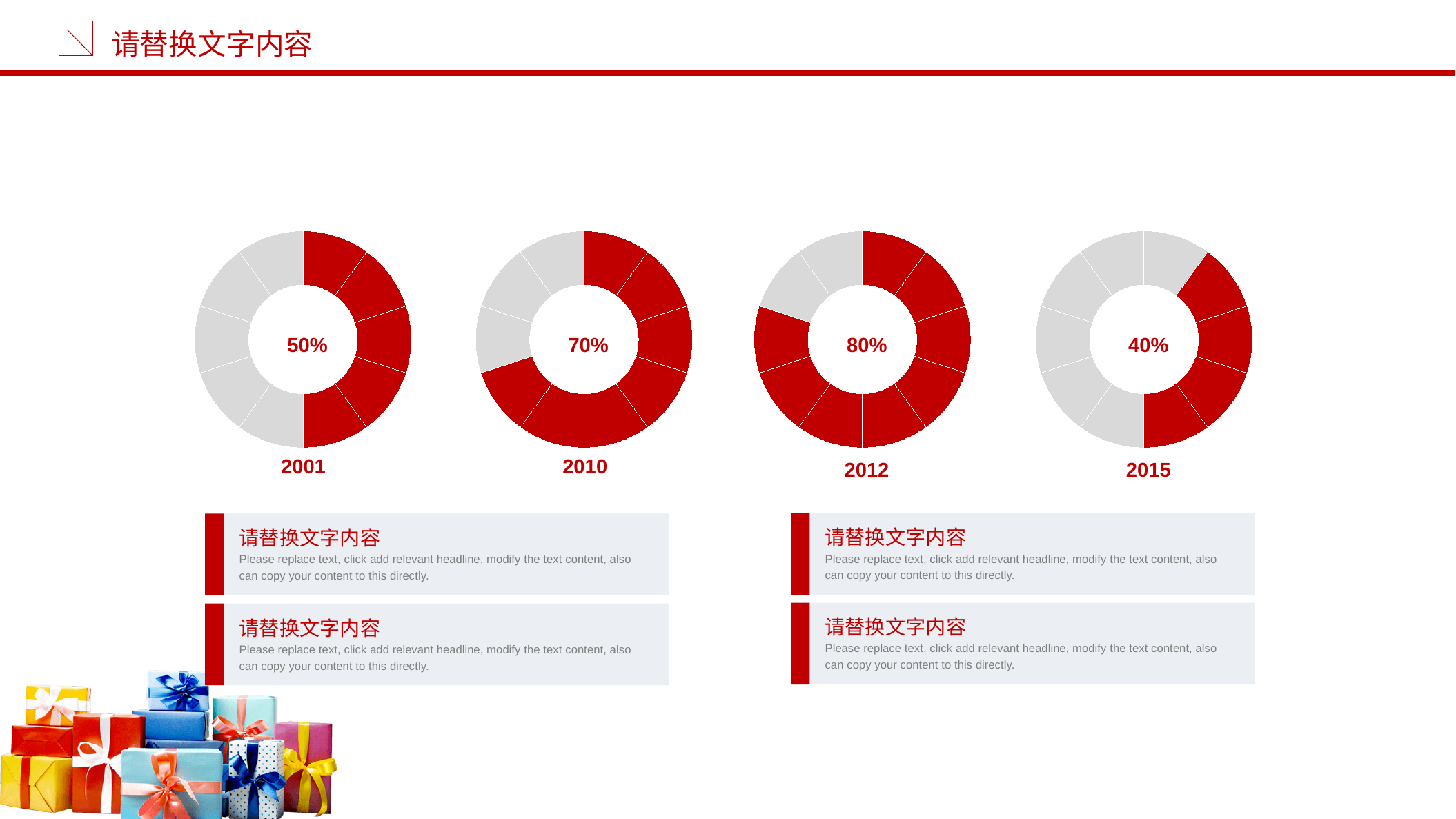
What colour is the filled (highlighted) portion of each donut chart? Red What percentage is shown in the centre of the donut chart labelled 2001? 50% What is the difference between the percentage in the 2010 donut chart and the percentage in the 2015 donut chart? 30% How many donut charts are shown on the slide? 4 What percentage is shown in the centre of the donut chart labelled 2012? 80% What kind of chart is used for the 2001 figure on the slide? Donut chart What percentage is shown in the centre of the donut chart labelled 2010? 70% What is the difference between the percentage in the 2012 donut chart and the percentage in the 2001 donut chart? 30% What percentage is shown in the centre of the donut chart labelled 2015? 40% Across the four donut charts, which year has the highest percentage? 2012 Which is larger: the percentage in the 2010 donut chart or the percentage in the 2015 donut chart? 2010 Across the four donut charts, which year has the lowest percentage? 2015